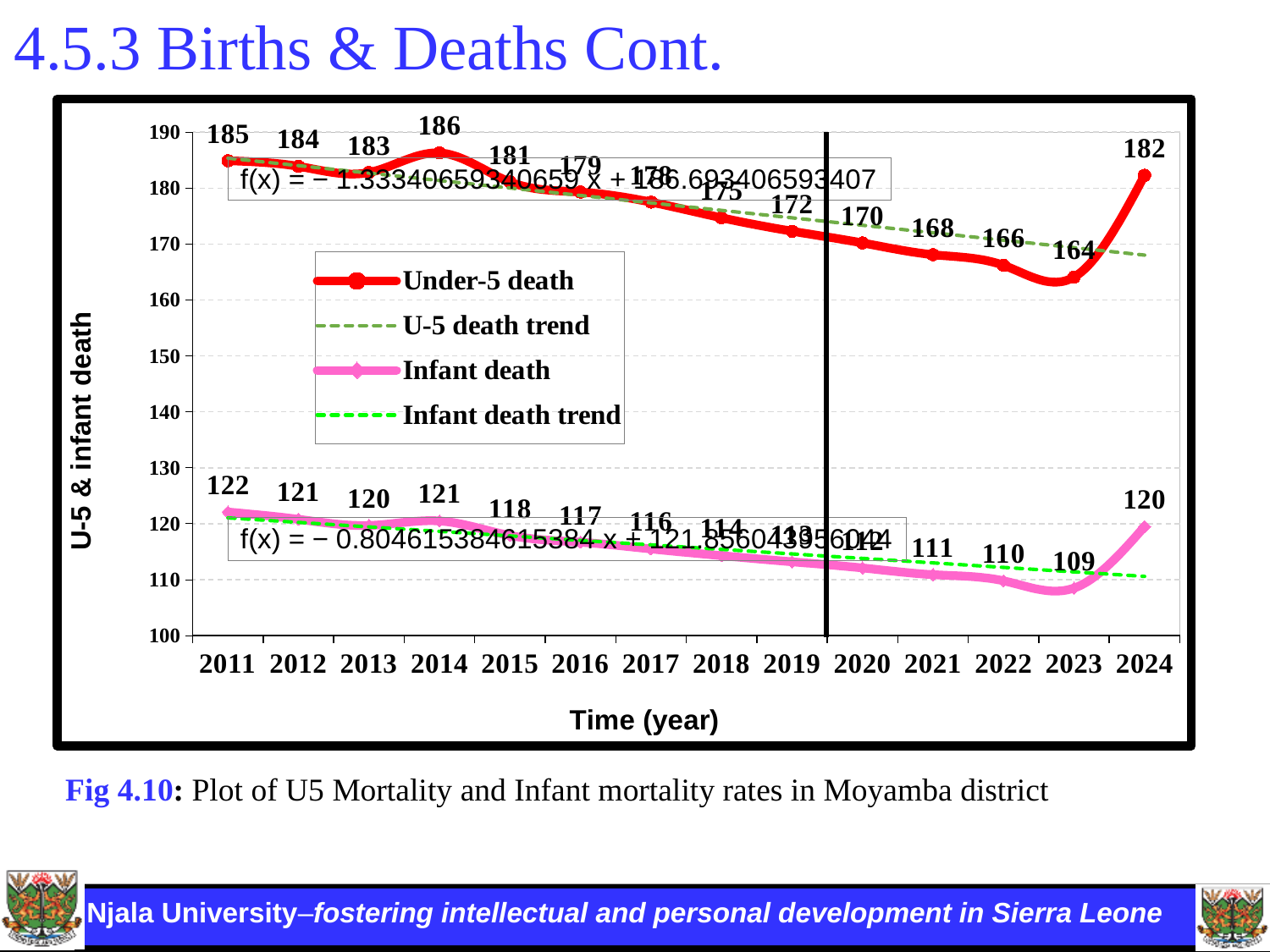
What is the Under-5 death value for 2011? 185 How many years are plotted on the x axis? 14 What is the Infant death value for 2024? 120 What is the Under-5 death value for 2023? 164 In which year is the Infant death value lowest? 2023 What is the Infant death value for 2015? 118 In which year is the Under-5 death value highest? 2014 How many series does the legend list? 4 Which is larger, the Under-5 death value in 2014 or in 2021? 2014 What is the label of the y axis? U-5 & infant death What is the difference between the Under-5 death value and the Infant death value in 2024? 62 What kind of chart is shown on the slide? Line chart